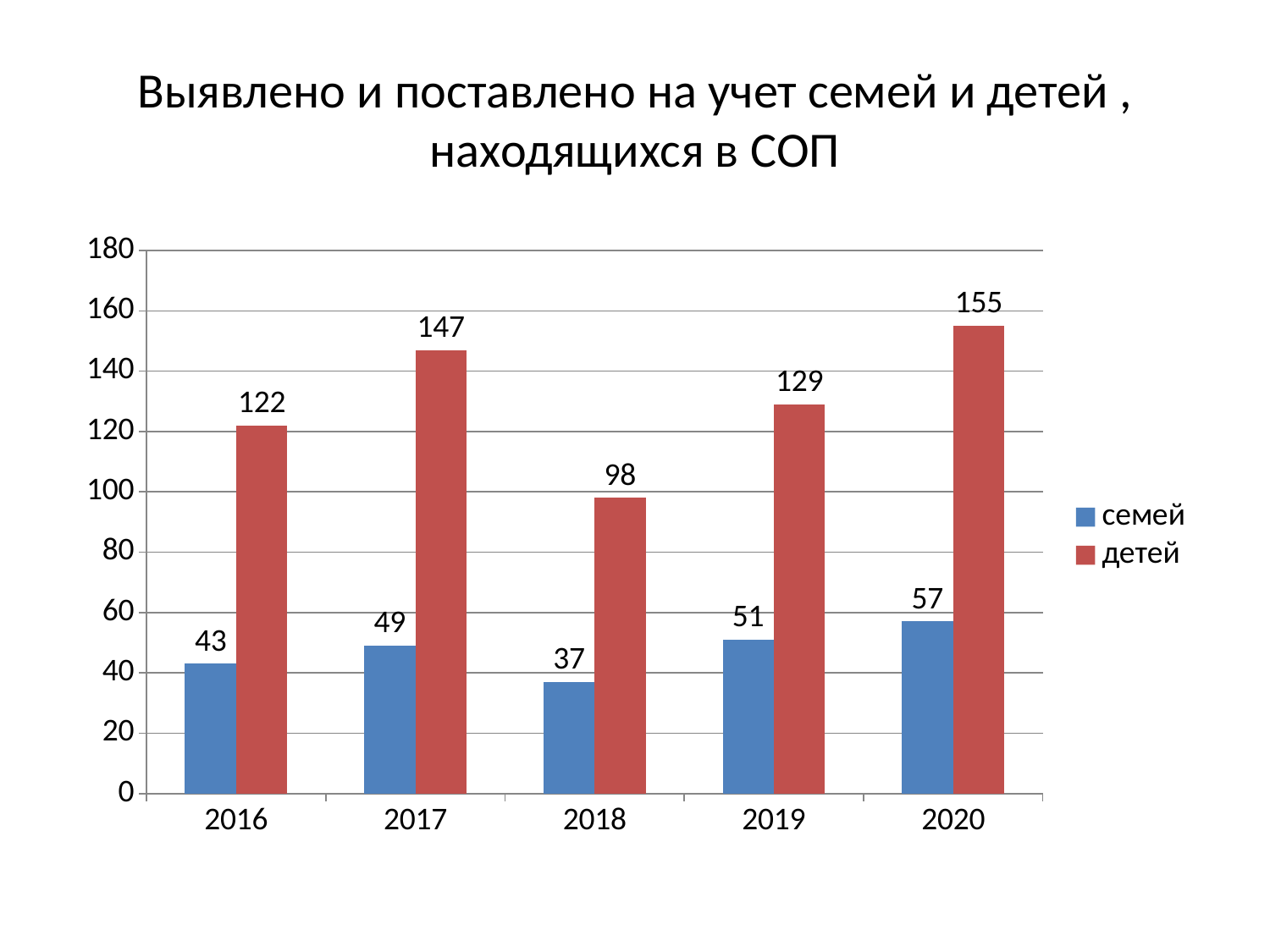
Which is larger: детей in 2016 or детей in 2019? детей in 2019 What kind of chart is shown on the slide? bar chart How many years are shown on the x axis? 5 What is the value for детей in 2017? 147 In which year is the value for детей highest? 2020 Does the value for семей rise or fall from 2018 to 2020? rise What is the value for семей in 2018? 37 How many series does the legend list? 2 Which colour represents the семей series? blue Is the value for детей in 2018 greater or less than 100? less In which year is the value for семей lowest? 2018 What is the difference between детей and семей in 2020? 98